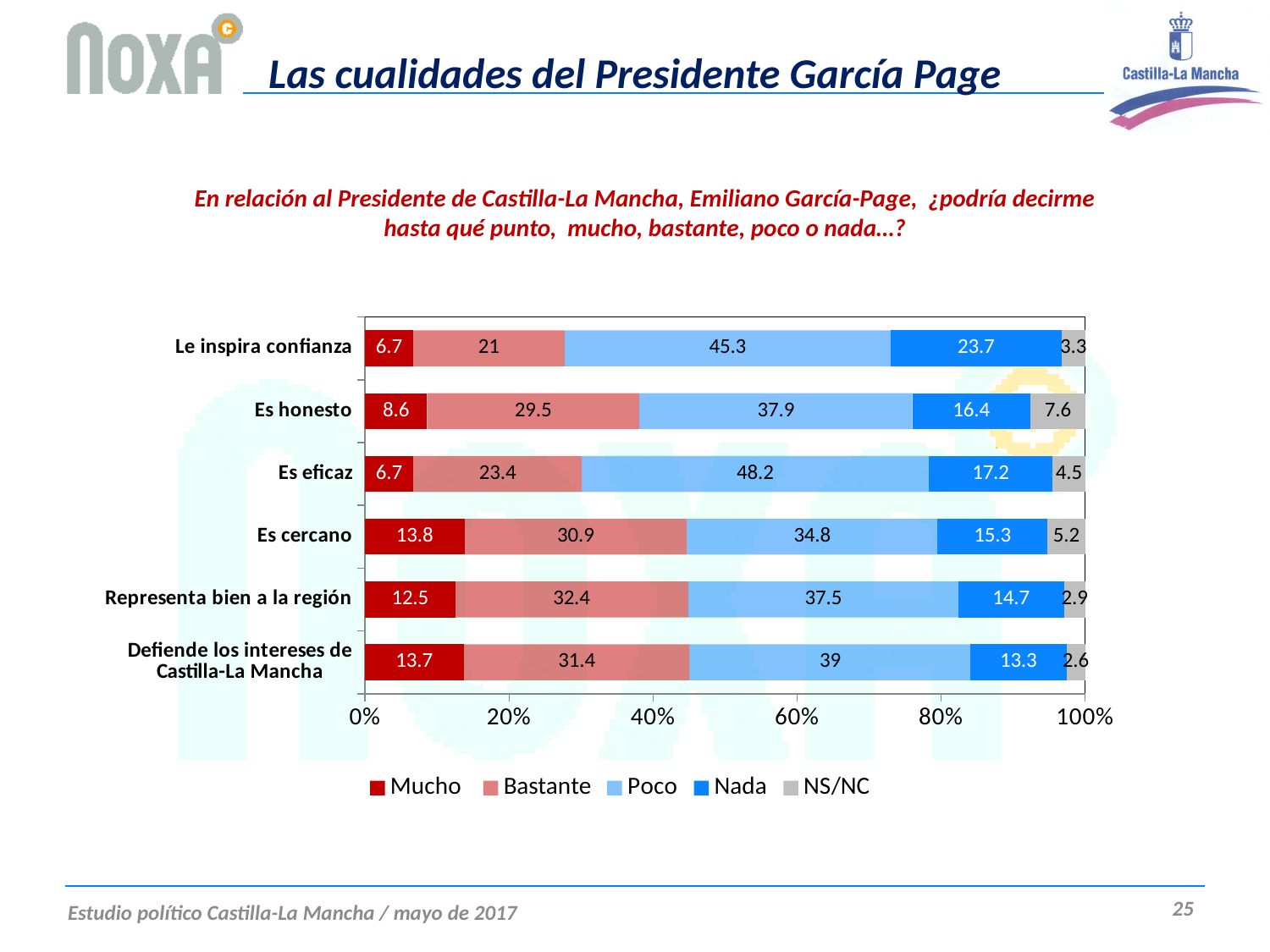
How many categories (qualities) are shown on the chart? 6 Which category has the highest "Nada" value? Le inspira confianza Which category has the highest "Poco" value? Es eficaz What percentage of respondents answered "Poco" for "Es eficaz"? 48.2 What is the "NS/NC" value for "Es honesto"? 7.6 What is the "Mucho" value for "Representa bien a la región"? 12.5 Which is larger: the "Bastante" value for "Es cercano" or for "Es honesto"? Es cercano How many series does the legend list? 5 Which category has the lowest "NS/NC" value? Defiende los intereses de Castilla-La Mancha What is the "Nada" value for "Le inspira confianza"? 23.7 What is the difference between the "Poco" values for "Es eficaz" and "Es honesto"? 10.3 What kind of chart is shown on the slide? Stacked bar chart